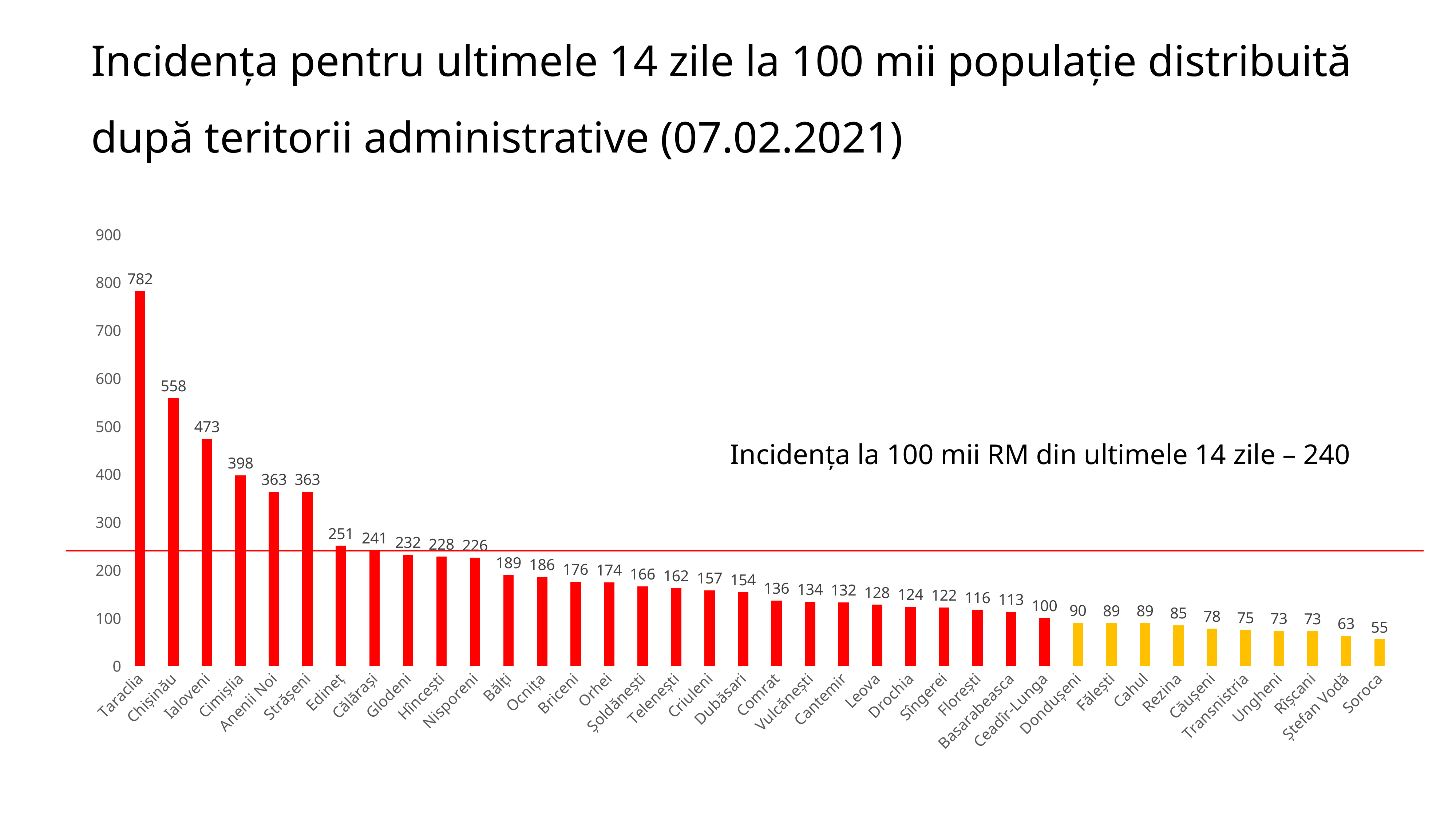
Which is larger, the value for Ialoveni or the value for Cimișlia? Ialoveni What is the value for Cahul? 89 What national incidence value is indicated by the horizontal line label on the chart? 240 What is the value for Chișinău? 558 What is the difference between the values for Taraclia and Chișinău? 224 What is the value for Bălți? 189 How many territories are shown on the x axis? 38 Do the values rise or fall from left to right along the x axis? Fall Which territory has the highest incidence? Taraclia Which territory has the lowest incidence? Soroca What kind of chart is this? Bar chart What is the value for Taraclia? 782